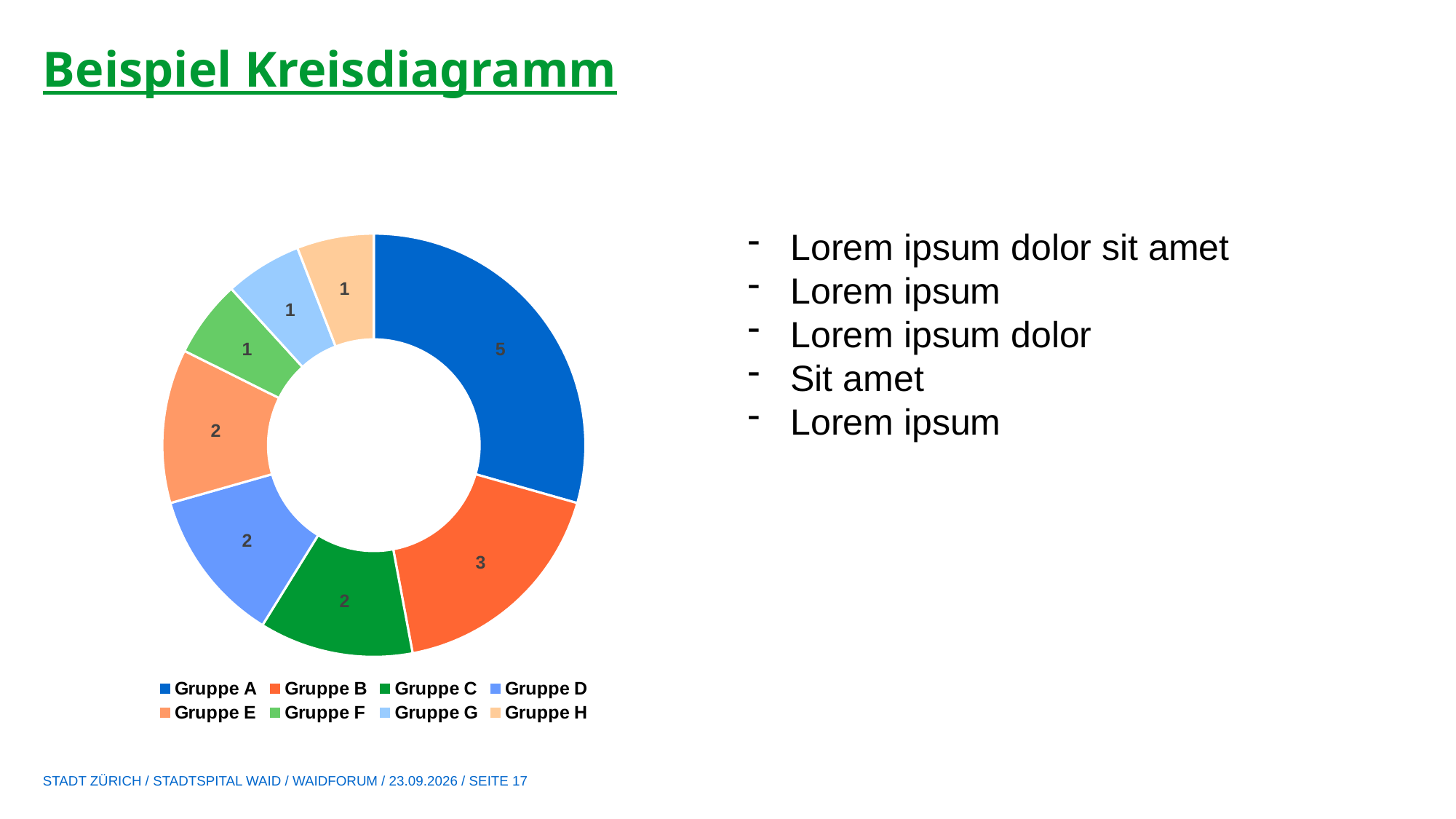
What is the difference between the values for Gruppe A and Gruppe B? 2 What is the value for Gruppe H? 1 Which group has the largest slice? Gruppe A What kind of chart is shown on the slide? doughnut chart How many entries does the legend list? 8 What is the value for Gruppe A? 5 What is the title of the slide? Beispiel Kreisdiagramm Which is larger, the value for Gruppe B or the value for Gruppe C? Gruppe B What is the total of all the values in the chart? 17 What is the value for Gruppe B? 3 How many groups are shown in the chart? 8 What is the value for Gruppe E? 2